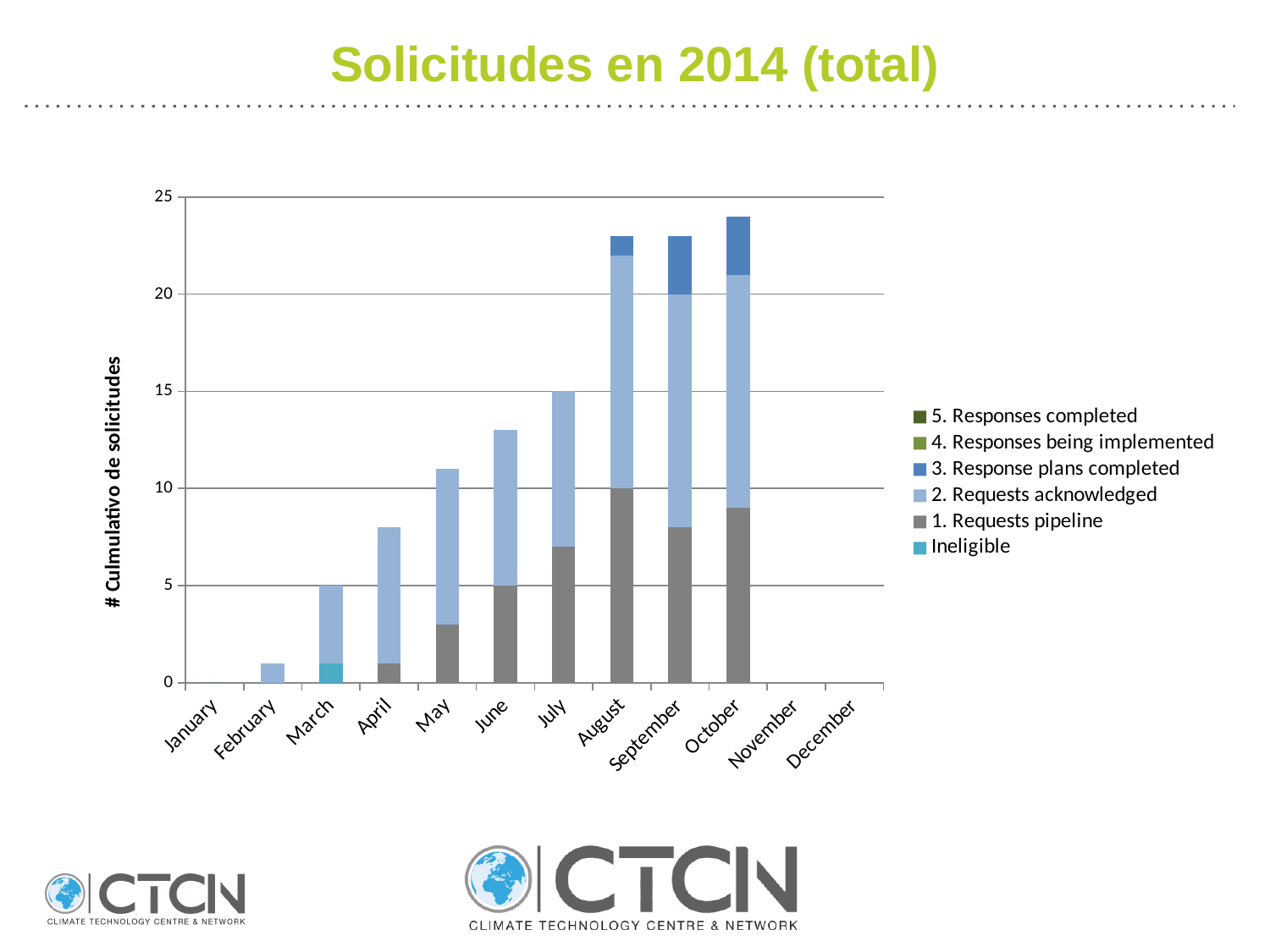
Do the bar totals generally rise or fall from February to October? Rise Is the total for February greater or less than 5? less What kind of chart is shown on the slide? Stacked bar chart What is the title of the chart? Solicitudes en 2014 (total) Which has a larger total, October or July? October What is the total height of the stacked bar for March? 5 What is the value of '1. Requests pipeline' for August? 10 Is the total for October greater or less than 20? greater What is the total height of the stacked bar for July? 15 What is the value of '1. Requests pipeline' for June? 5 How many series does the legend list? 6 How many months are shown on the x axis? 12